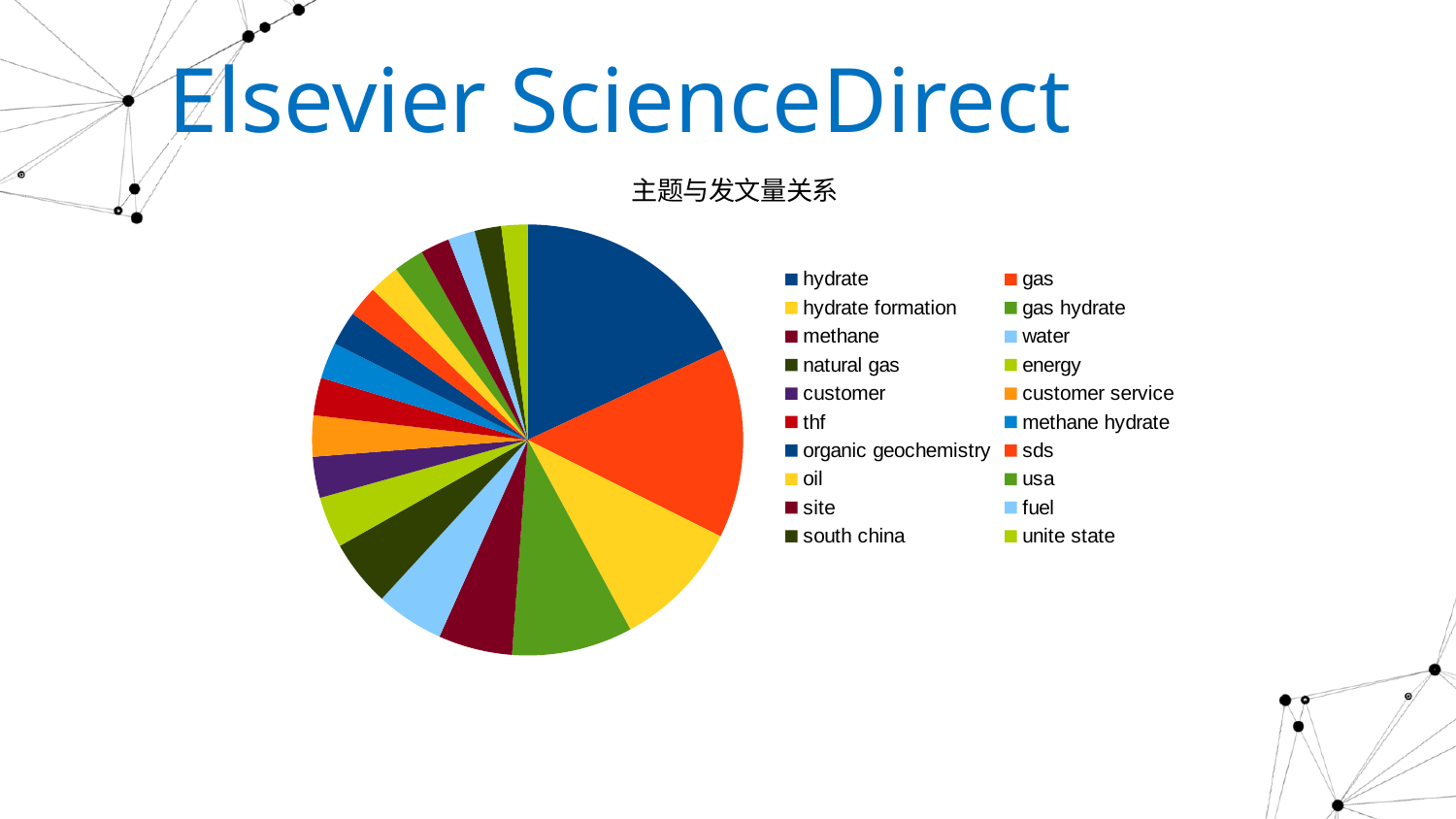
Which slice is larger in the pie chart, gas or unite state? gas Which slice is larger in the pie chart, hydrate formation or oil? hydrate formation What kind of chart is shown on the slide? pie chart What is the title of the pie chart? 主题与发文量关系 Which slice is larger in the pie chart, gas hydrate or fuel? gas hydrate How many categories does the pie chart's legend list? 20 What colour is the hydrate slice in the pie chart? dark blue Which category has the largest slice in the pie chart? hydrate